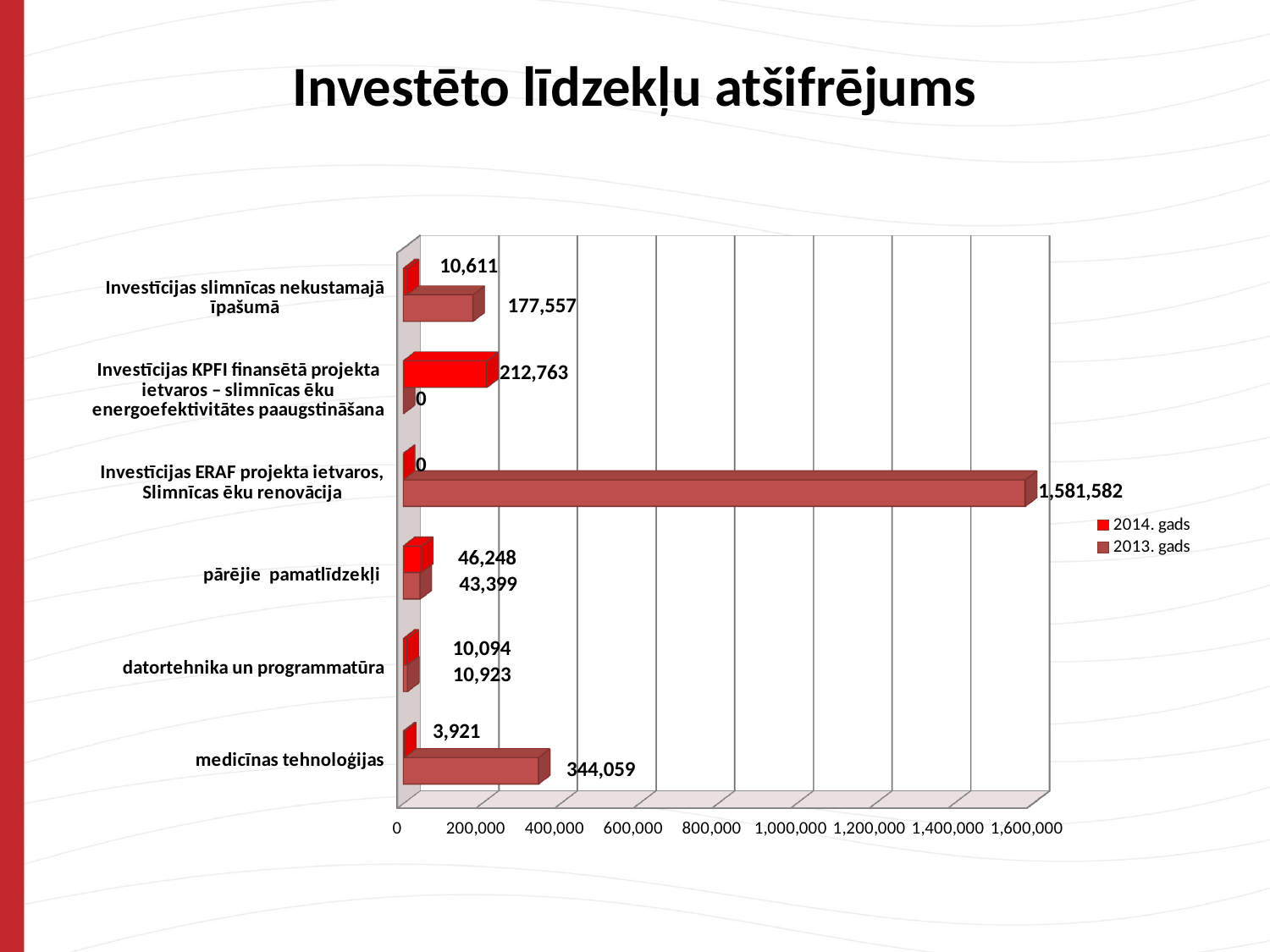
What is the 2014. gads value for Investīcijas KPFI finansētā projekta ietvaros – slimnīcas ēku energoefektivitātes paaugstināšana? 212,763 Which category has the highest 2013. gads value? Investīcijas ERAF projekta ietvaros, Slimnīcas ēku renovācija What is the 2014. gads value for pārējie pamatlīdzekļi? 46,248 Which category has the lowest 2014. gads value? Investīcijas ERAF projekta ietvaros, Slimnīcas ēku renovācija What is the title of the chart? Investēto līdzekļu atšifrējums How many series does the legend list? 2 Is the 2013. gads value for Investīcijas ERAF projekta ietvaros, Slimnīcas ēku renovācija greater or less than 1,400,000? greater How many categories are shown on the chart? 6 What is the difference between the 2013. gads and 2014. gads values for Investīcijas slimnīcas nekustamajā īpašumā? 166,946 For medicīnas tehnoloģijas, which series has the larger value, 2014. gads or 2013. gads? 2013. gads What is the 2013. gads value for medicīnas tehnoloģijas? 344,059 What kind of chart is shown on the slide? bar chart